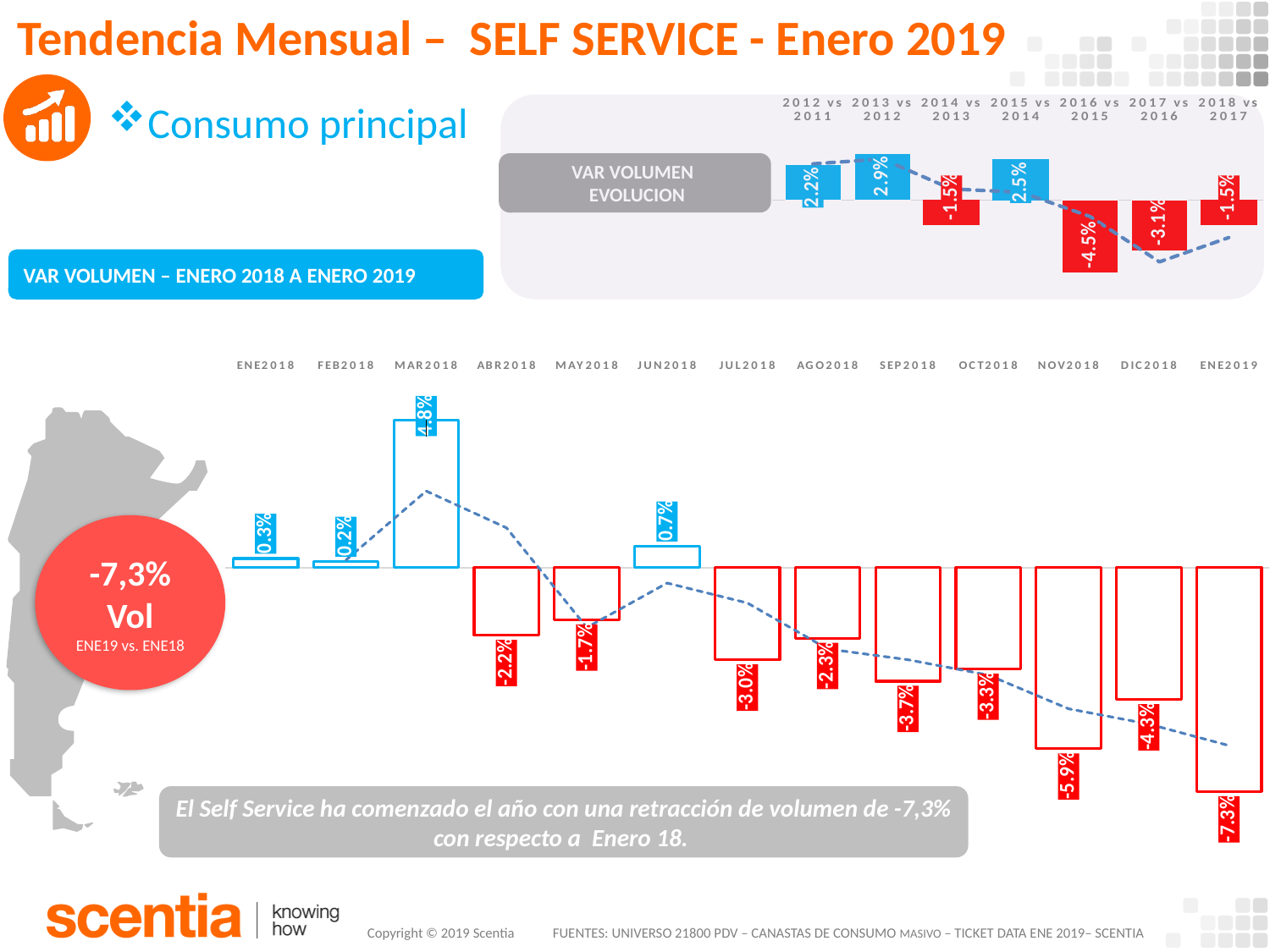
In the chart 'VAR VOLUMEN – ENERO 2018 A ENERO 2019', how many months are plotted? 13 In the chart 'VAR VOLUMEN EVOLUCION' at the top right, what is the value for 2016 vs 2015? -4.5% In the chart 'VAR VOLUMEN – ENERO 2018 A ENERO 2019', do the values generally rise or fall from JUN2018 to ENE2019? fall In the chart 'VAR VOLUMEN – ENERO 2018 A ENERO 2019', which month has the lowest value? ENE2019 In the chart 'VAR VOLUMEN – ENERO 2018 A ENERO 2019', which is larger, the value for JUL2018 or the value for SEP2018? JUL2018 In the chart 'VAR VOLUMEN – ENERO 2018 A ENERO 2019', what is the value for MAR2018? 4.8% In the chart 'VAR VOLUMEN – ENERO 2018 A ENERO 2019', which month has the highest value? MAR2018 In the chart 'VAR VOLUMEN – ENERO 2018 A ENERO 2019', what is the value for NOV2018? -5.9% In the chart 'VAR VOLUMEN – ENERO 2018 A ENERO 2019', what is the value for ENE2019? -7.3% In the chart 'VAR VOLUMEN – ENERO 2018 A ENERO 2019', what is the difference between the values for MAR2018 and ENE2019? 12.1 percentage points In the chart 'VAR VOLUMEN EVOLUCION' at the top right, which period has the highest value? 2013 vs 2012 What kind of chart is 'VAR VOLUMEN – ENERO 2018 A ENERO 2019'? bar chart with a dashed trend line